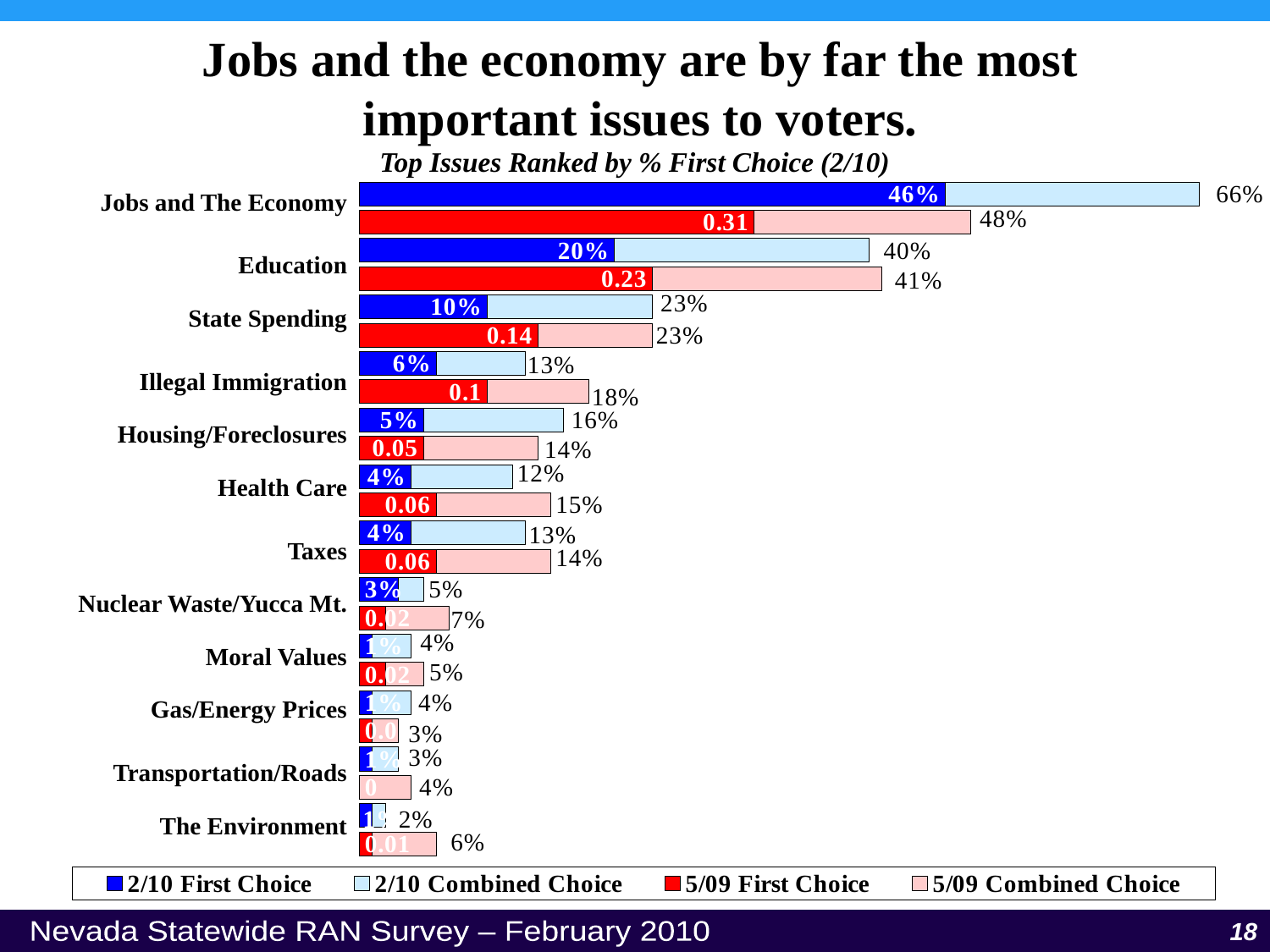
Which issue has the lowest 2/10 Combined Choice value? The Environment Which is larger for Health Care: the 2/10 Combined Choice value or the 5/09 Combined Choice value? 5/09 Combined Choice What is the 2/10 Combined Choice value for Education? 40% Which issue has the highest 2/10 First Choice value? Jobs and The Economy How many series does the legend list? 4 What is the 2/10 First Choice value for Jobs and The Economy? 46% How many issues are listed on the chart? 12 What is the difference between the 2/10 Combined Choice values for Jobs and The Economy and Education? 26% What is the 5/09 Combined Choice value for Illegal Immigration? 18% What is the subtitle of the chart? Top Issues Ranked by % First Choice (2/10) What kind of chart is shown on the slide? Bar chart What is the 5/09 First Choice value for State Spending? 0.14